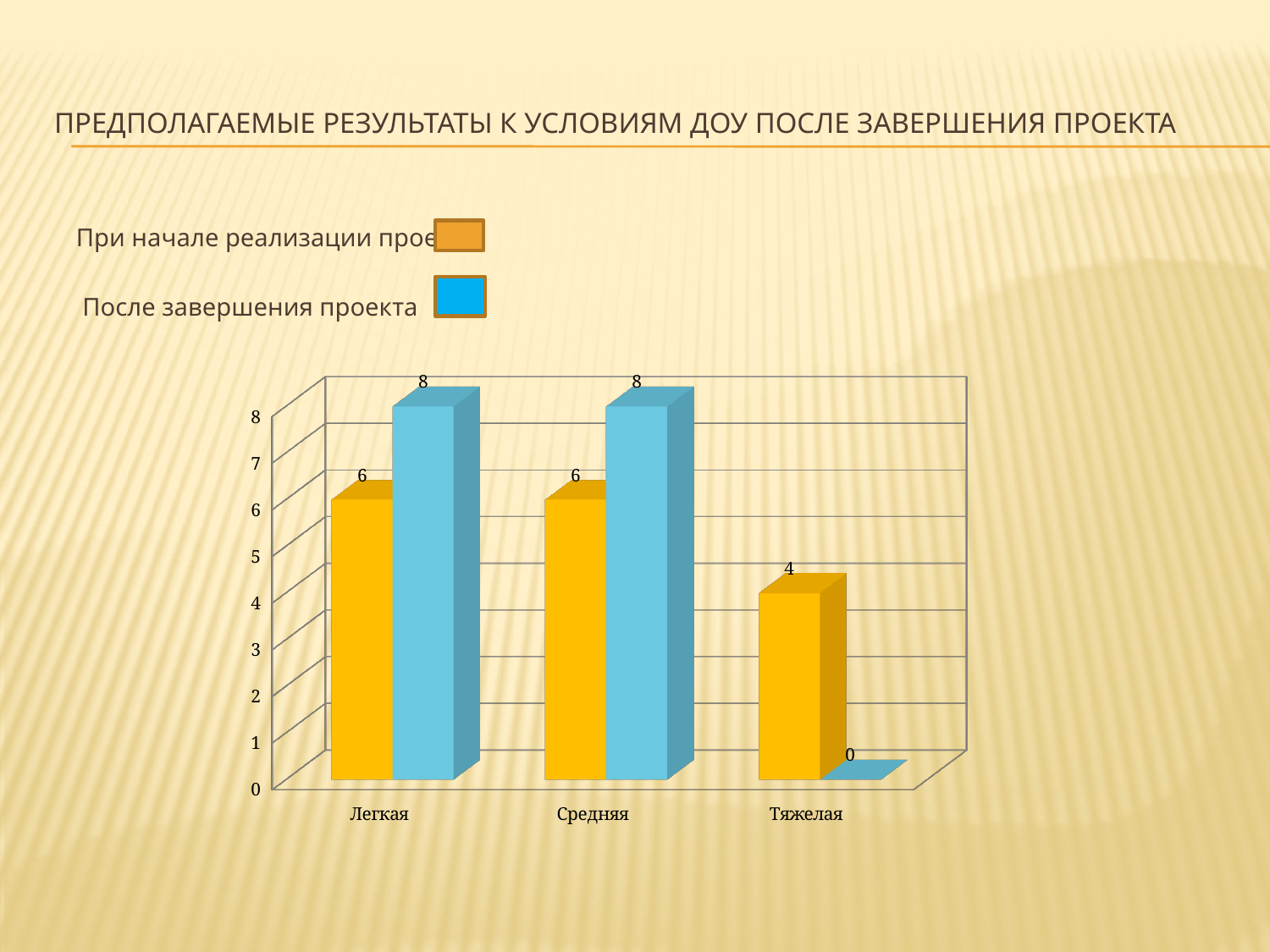
What is the difference between the blue bar and the orange bar for Легкая? 2 What is the value for Тяжелая in the После завершения проекта series? 0 For Тяжелая, which is larger: the orange bar or the blue bar? the orange bar What is the value of the orange bar for Средняя? 6 Do the values of the orange bars rise or fall from Легкая to Тяжелая? fall What kind of chart is shown on the slide? bar chart What is the value for Легкая in the После завершения проекта series? 8 Which category has the lowest value in the После завершения проекта series? Тяжелая What is the value of the orange bar for Тяжелая? 4 What colour represents the После завершения проекта series? blue How many categories are shown on the x axis of the chart? 3 Which category has the lowest value among the orange bars? Тяжелая